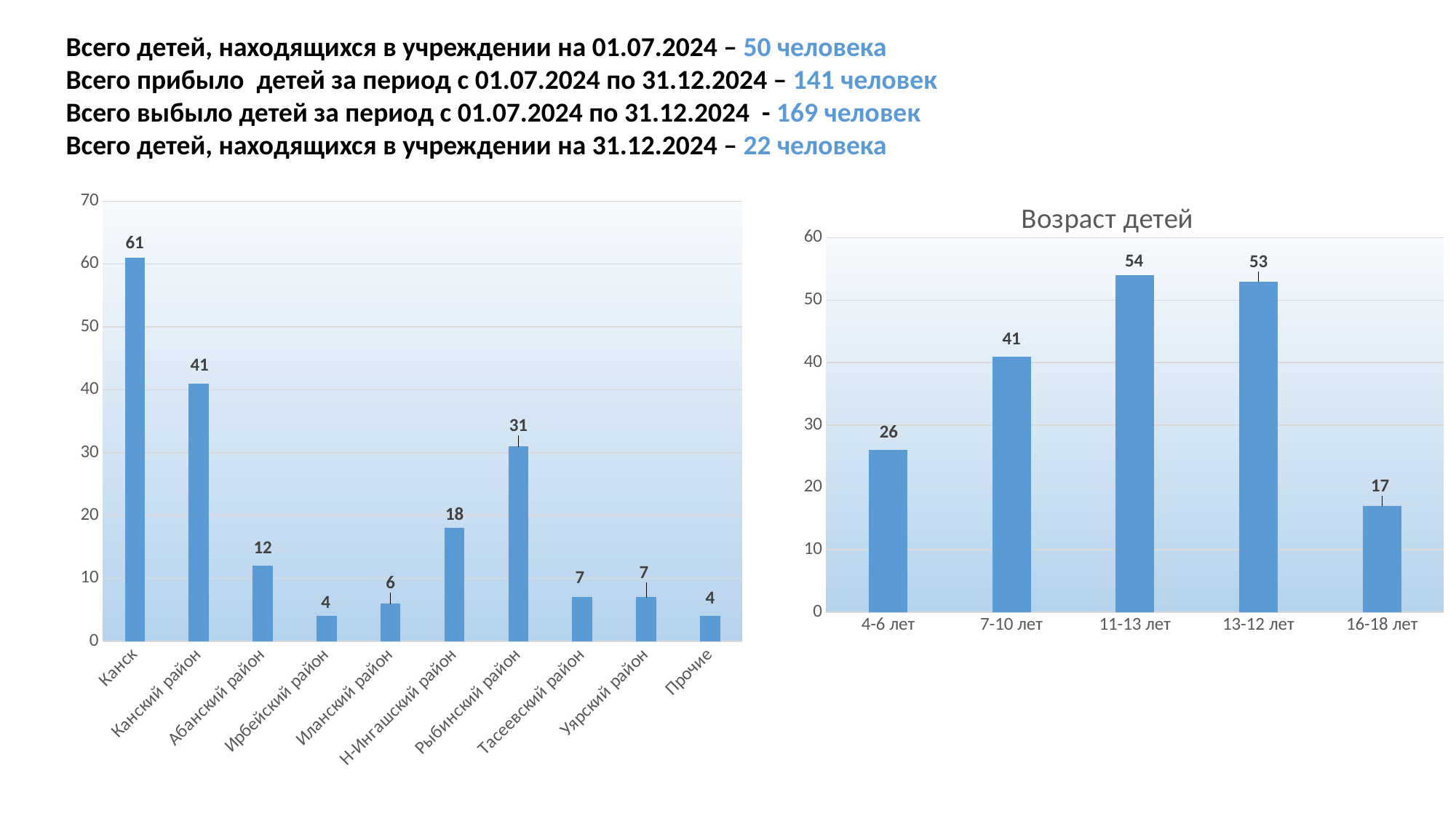
In the chart titled 'Возраст детей', what is the difference between 11-13 лет and 4-6 лет? 28 How many age groups are shown in the chart titled 'Возраст детей'? 5 In the left chart, which category has the highest value? Канск In the left chart, what is the value for Рыбинский район? 31 In the left chart, which is larger: Абанский район or Н-Ингашский район? Н-Ингашский район In the left chart, what is the difference between Канск and Канский район? 20 What is the title of the right chart? Возраст детей In the chart titled 'Возраст детей', which age group has the lowest value? 16-18 лет In the chart titled 'Возраст детей', what is the value for 7-10 лет? 41 In the left chart, what is the value for Канск? 61 What kind of chart is the left chart? bar chart How many categories are shown in the left chart? 10